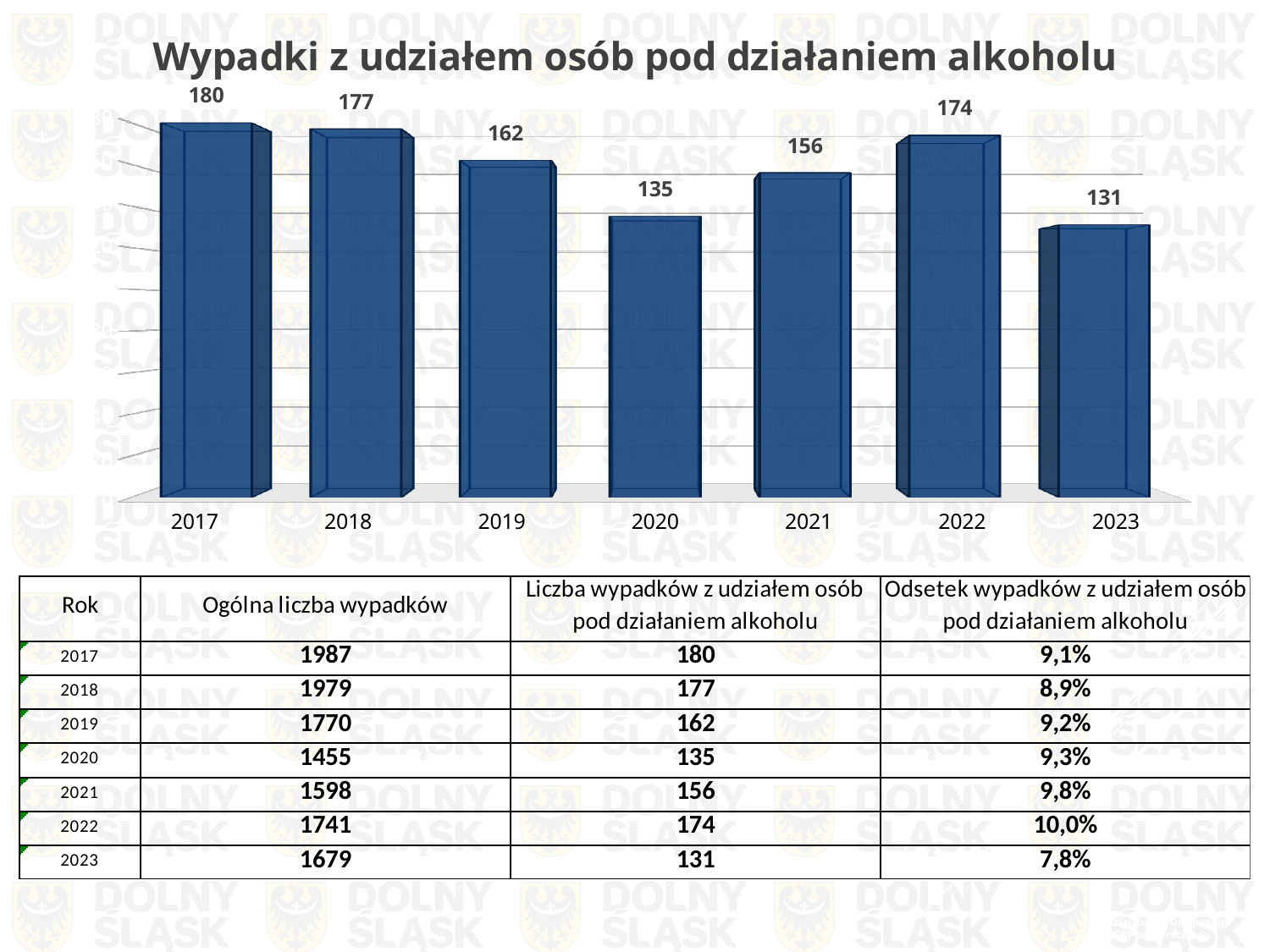
Which is larger, the value for 2019 or the value for 2021? 2019 What is the value shown for 2020? 135 What is the value shown for 2022? 174 How many years are shown on the x axis of the chart? 7 What is the value shown for 2017? 180 What is the difference between the values for 2022 and 2021? 18 Which is larger, the value for 2020 or the value for 2023? 2020 What is the difference between the values for 2017 and 2023? 49 What is the title of the chart? Wypadki z udziałem osób pod działaniem alkoholu Which year has the highest value in the chart? 2017 What kind of chart is shown on the slide? bar chart Which year has the lowest value in the chart? 2023